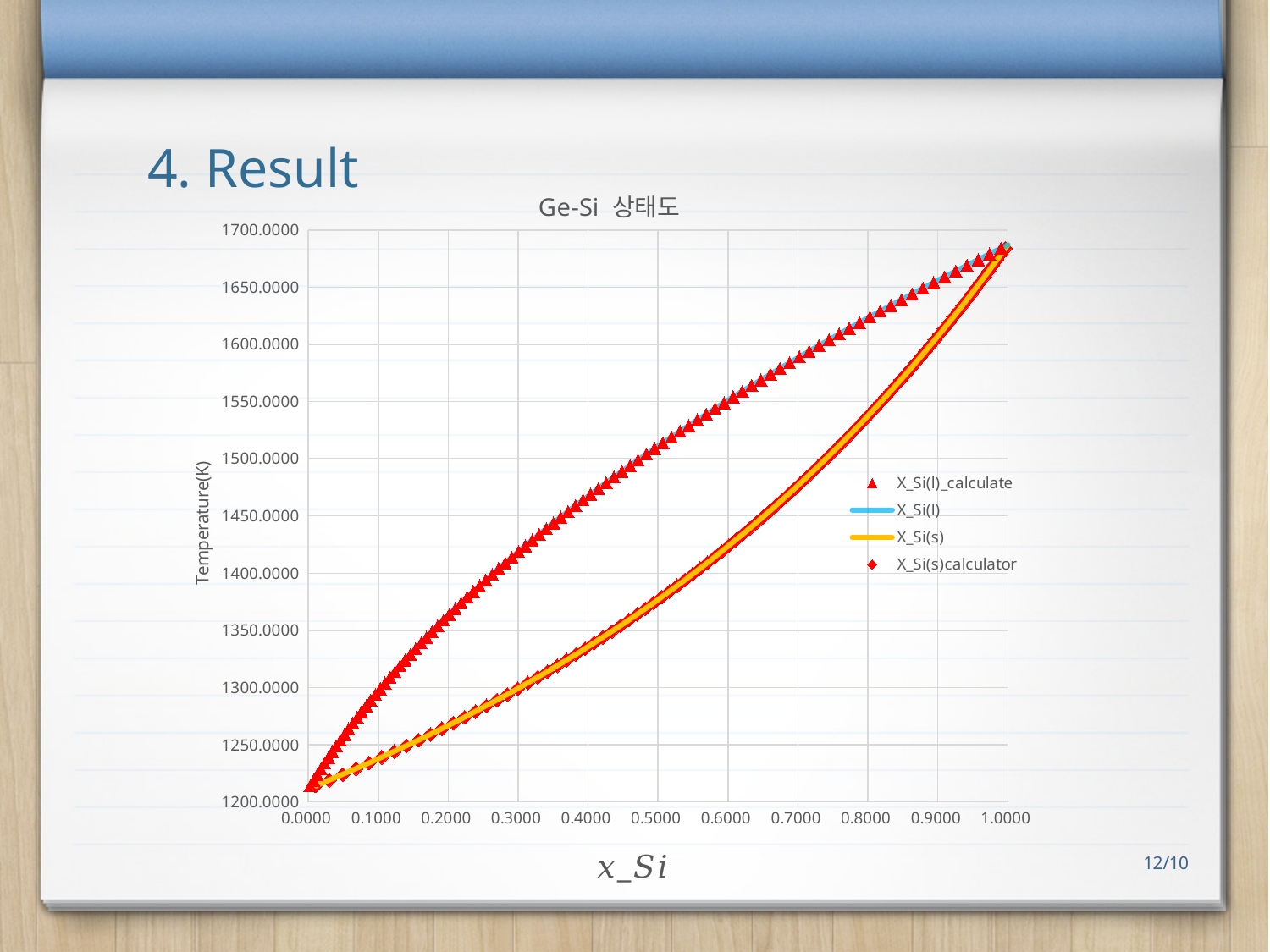
What kind of chart is shown on the slide? line chart What is the label of the vertical axis? Temperature(K) Is the temperature of the X_Si(l) series at x_Si = 0.7000 greater or less than 1550.0000? greater How many series does the chart legend list? 4 At x_Si = 0.5000, which series has the higher temperature, X_Si(l) or X_Si(s)? X_Si(l) Is the temperature of the X_Si(s) series at x_Si = 0.7000 greater or less than 1500.0000? less Is the temperature of the X_Si(s) series at x_Si = 0.1000 greater or less than 1250.0000? less Do the temperature values of the X_Si(s) series rise or fall as x_Si increases from 0 to 1? rise Do the temperature values of the X_Si(l) series rise or fall as x_Si increases from 0 to 1? rise What is the title of the chart? Ge-Si 상태도